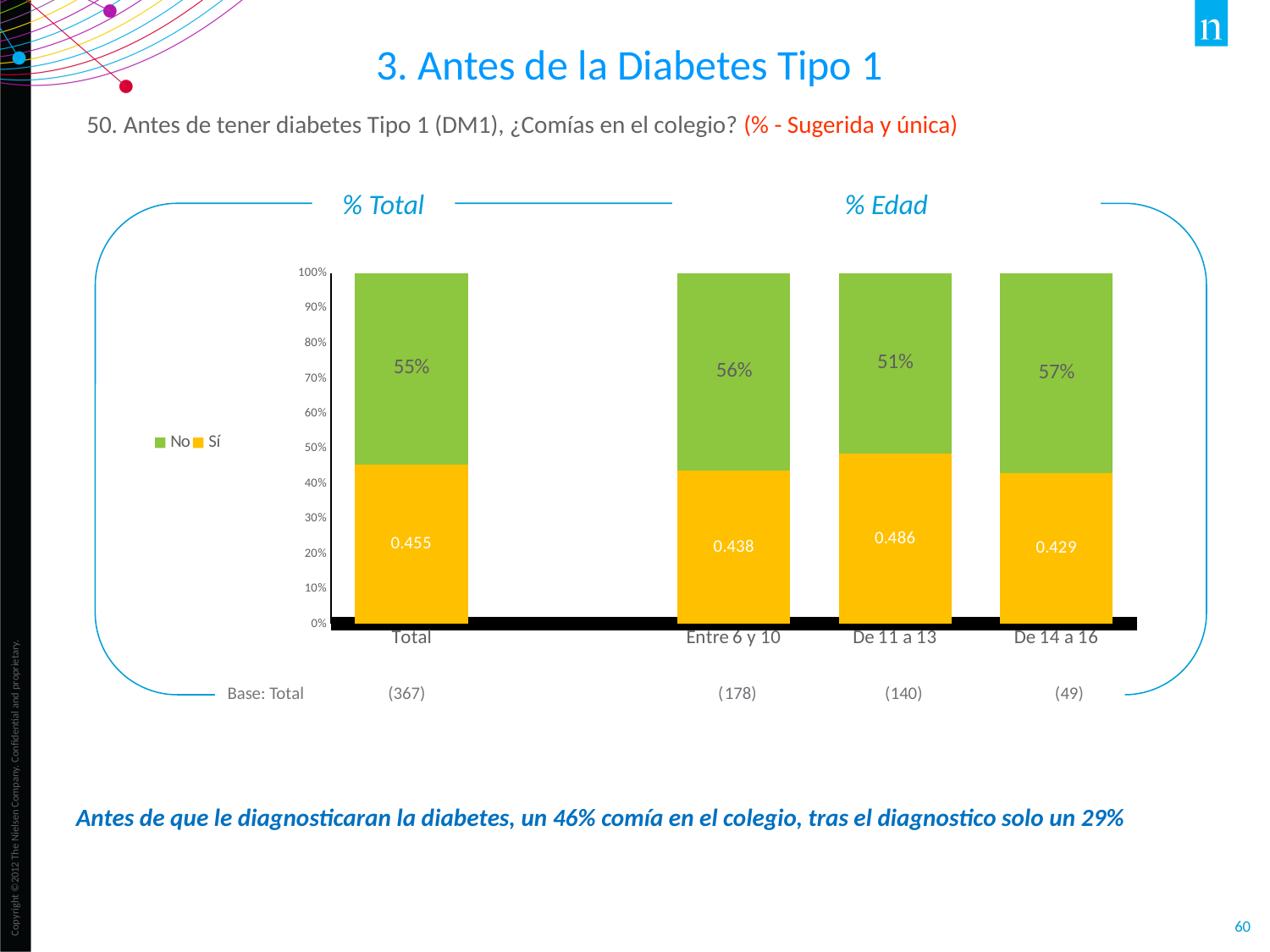
What type of chart is shown on the slide? stacked bar chart What is the data label for the 'No' series in the 'Total' bar? 55% Which is larger, the 'No' value for 'De 11 a 13' or the 'No' value for 'Entre 6 y 10'? Entre 6 y 10 Which category has the lowest 'Sí' value? De 14 a 16 Which category has the highest 'No' value? De 14 a 16 What is the data label for the 'Sí' series in the 'Total' bar? 0.455 Which series is shown in green in the chart legend? No What is the data label for the 'No' series in the 'De 14 a 16' bar? 57% What is the data label for the 'Sí' series in the 'De 11 a 13' bar? 0.486 How many series does the chart legend list? 2 How many categories are plotted along the x axis of the chart? 4 What is the data label for the 'Sí' series in the 'Entre 6 y 10' bar? 0.438